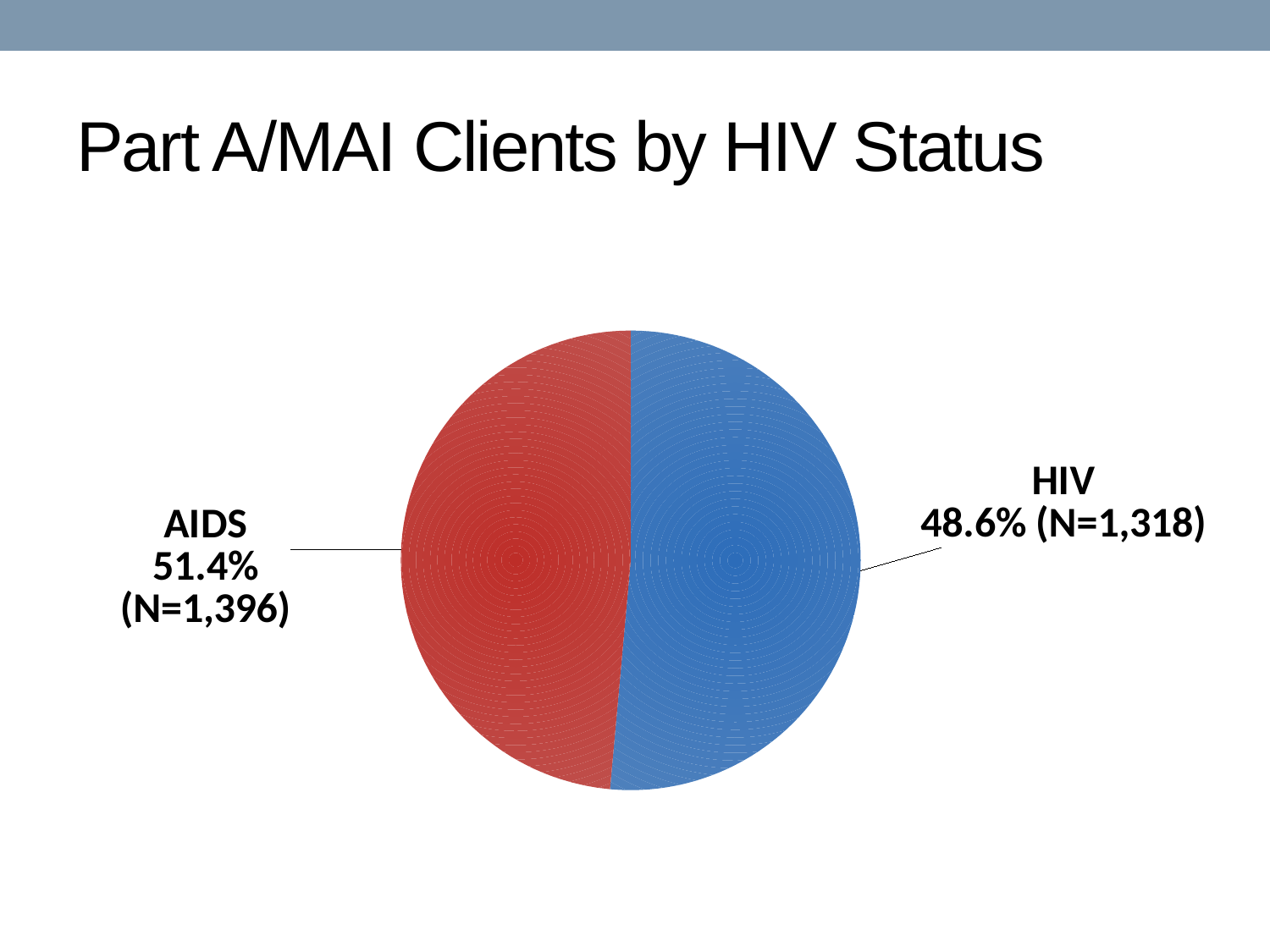
What percentage of Part A/MAI clients have HIV status? 48.6% How many categories does the pie chart show? 2 What is the title of the chart? Part A/MAI Clients by HIV Status Which HIV status category has the larger share of clients? AIDS How many clients are in the HIV category? 1,318 What is the total number of clients across both categories? 2,714 What percentage of Part A/MAI clients have AIDS status? 51.4% What type of chart is shown on the slide? pie chart How many clients are in the AIDS category? 1,396 How many more clients are in the AIDS category than in the HIV category? 78 Which HIV status category has the smaller share of clients? HIV What is the difference in percentage points between the AIDS and HIV shares? 2.8